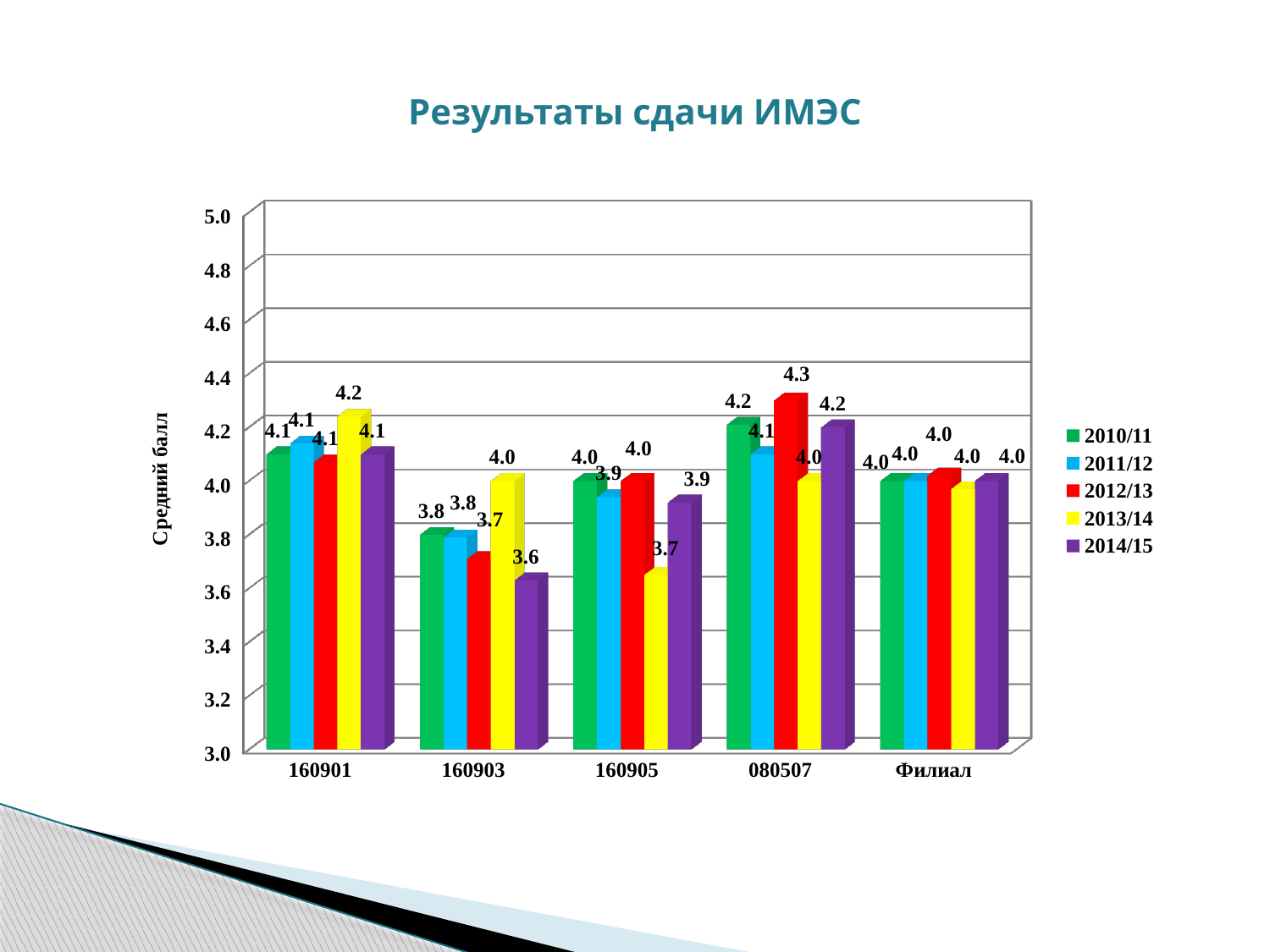
What is the value for 2013/14 in category 160901? 4.2 What is the title of the chart? Результаты сдачи ИМЭС How many series does the legend list? 5 What is the value for 2012/13 in category 080507? 4.3 How many categories are shown on the x axis? 5 Which is larger: the 2012/13 value for 160903 or the 2012/13 value for 160905? 160905 What type of chart is shown on the slide? bar chart What is the value for 2014/15 in category 160903? 3.6 Which series has the highest value in category 080507? 2012/13 What is the difference between the 2013/14 value and the 2014/15 value in category 160903? 0.4 Which series has the lowest value in category 160905? 2013/14 What is the label of the vertical axis? Средний балл